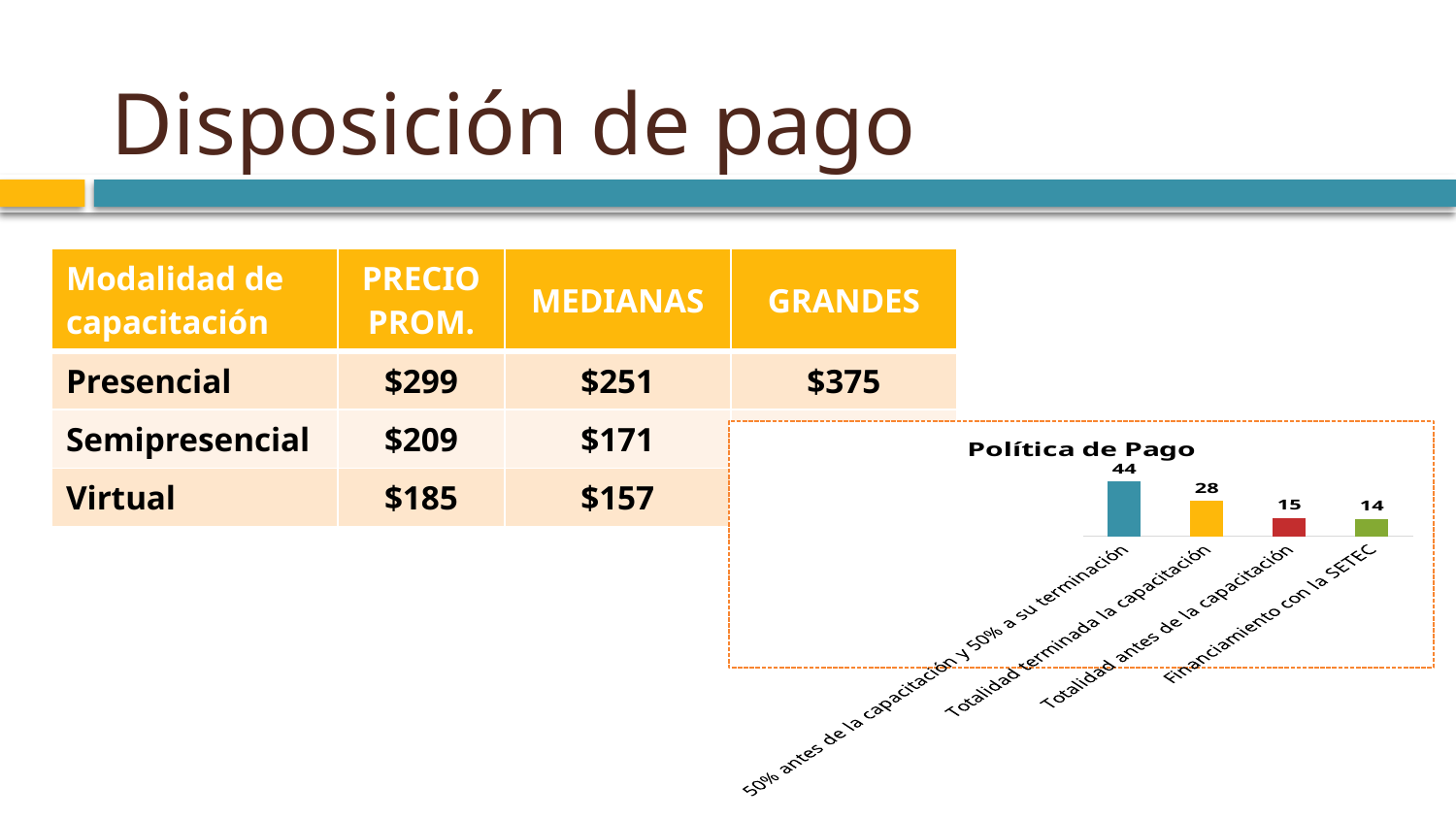
What is the value for "Totalidad antes de la capacitación" in the Política de Pago chart? 15 How many categories are shown in the Política de Pago chart? 4 What is the value for "50% antes de la capacitación y 50% a su terminación" in the Política de Pago chart? 44 Which category has the lowest value in the Política de Pago chart? Financiamiento con la SETEC What is the value for "Financiamiento con la SETEC" in the Política de Pago chart? 14 Do the values in the Política de Pago chart rise or fall from left to right? Fall Which category has the highest value in the Política de Pago chart? 50% antes de la capacitación y 50% a su terminación What is the value for "Totalidad terminada la capacitación" in the Política de Pago chart? 28 What is the title of the chart on the slide? Política de Pago What is the difference between the values for "50% antes de la capacitación y 50% a su terminación" and "Totalidad terminada la capacitación" in the Política de Pago chart? 16 In the Política de Pago chart, which is larger: "Totalidad terminada la capacitación" or "Totalidad antes de la capacitación"? Totalidad terminada la capacitación What kind of chart is the Política de Pago chart? Bar chart